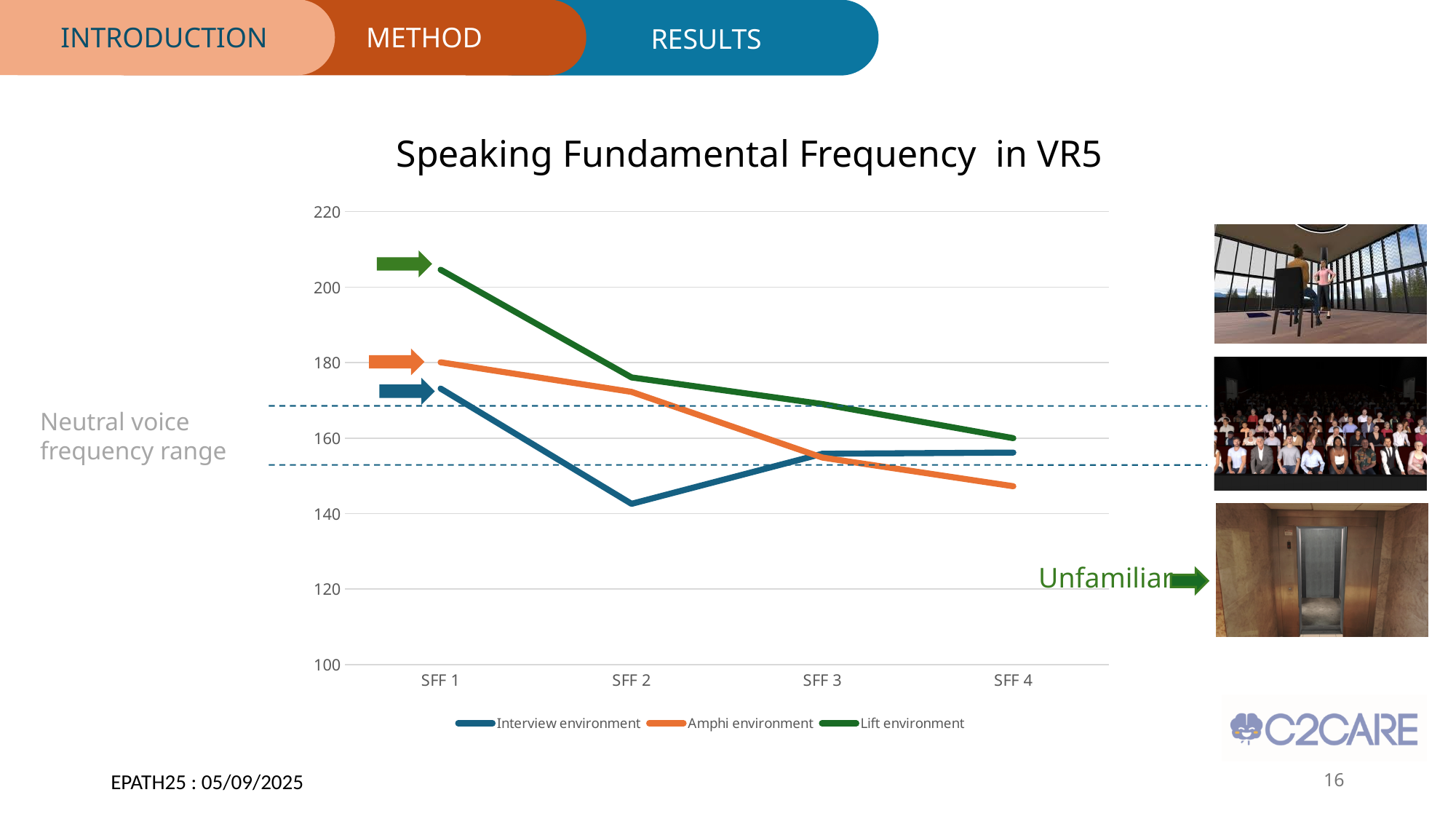
Is the value for Interview environment at SFF 2 greater or less than 160? less Which series has the lowest value at SFF 2? Interview environment Which series has the highest value at SFF 1? Lift environment Is the value for Amphi environment at SFF 4 greater or less than 160? less At SFF 2, which is larger: the Lift environment value or the Interview environment value? Lift environment Does the Lift environment line rise or fall from SFF 1 to SFF 4? Fall What kind of chart is shown on the slide? Line chart How many points are plotted along the x axis for each series? 4 Is the value for Lift environment at SFF 1 greater or less than 200? greater What is the title of the chart? Speaking Fundamental Frequency in VR5 Which series has the lowest value at SFF 4? Amphi environment How many series does the chart legend list? 3